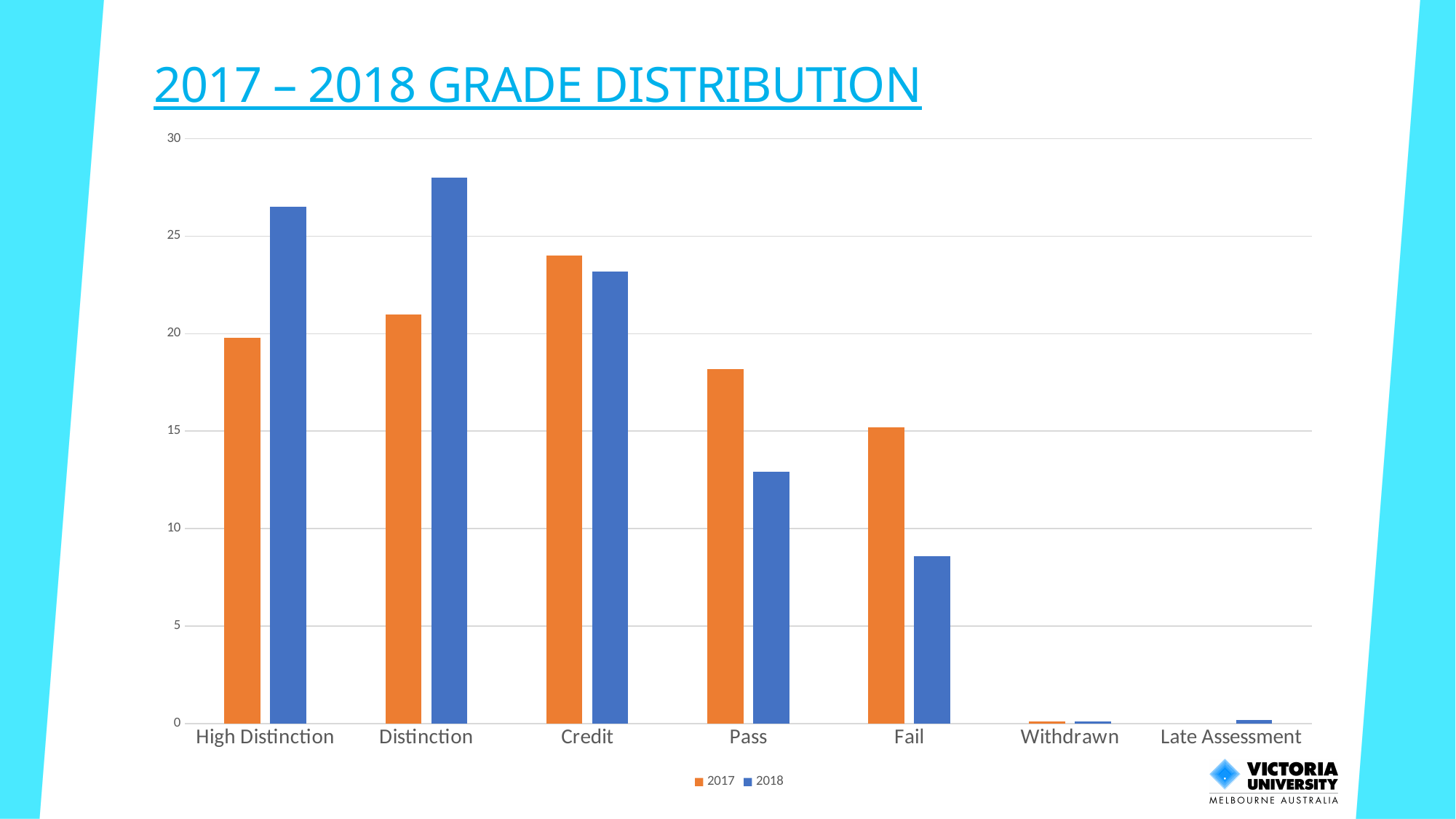
For High Distinction, which series has the larger value, 2017 or 2018? 2018 What is the title of the chart on the slide? 2017 – 2018 GRADE DISTRIBUTION How many series does the legend list? 2 How many grade categories are shown on the x axis? 7 For Fail, which series has the larger value, 2017 or 2018? 2017 For Pass, which series has the larger value, 2017 or 2018? 2017 Is the 2017 value for Pass greater or less than 20? less Which category has the highest value for the 2017 series? Credit Is the 2018 value for High Distinction greater or less than 25? greater What kind of chart is shown on the slide? bar chart Is the 2018 value for Fail greater or less than 10? less Which category has the highest value for the 2018 series? Distinction